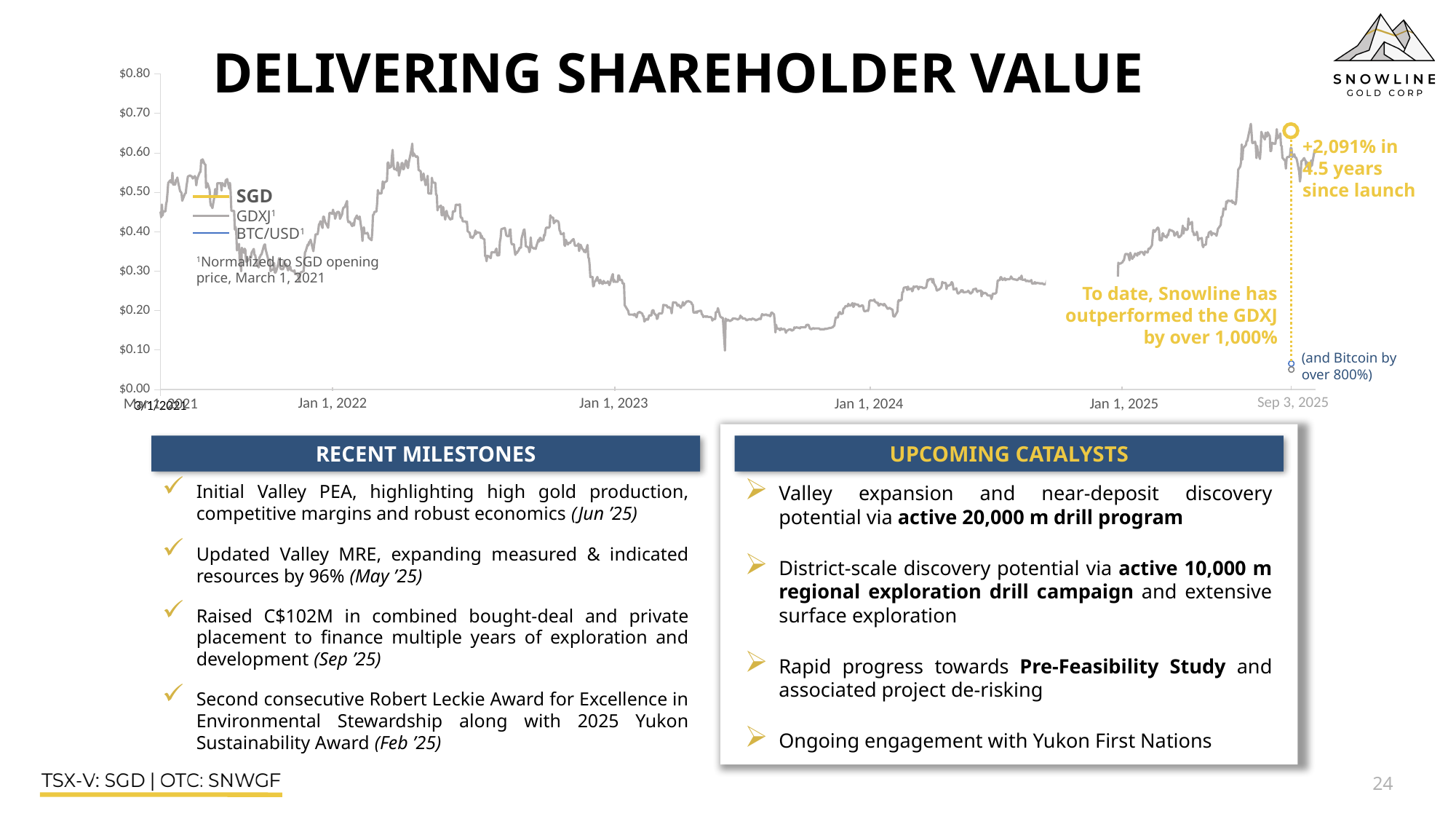
Is the value of the grey GDXJ line at Jan 1, 2024 greater or less than $0.30? less According to the chart annotation, by what percentage has SGD risen in 4.5 years since launch? +2,091% Which three series are listed in the chart legend? SGD, GDXJ, BTC/USD Is the value of the grey GDXJ line at Jan 1, 2022 greater or less than $0.30? greater What kind of chart is shown on the slide? line chart According to the chart annotation, by how much has Snowline outperformed the GDXJ to date? over 1,000% To what are the GDXJ and BTC/USD series normalized, according to the chart footnote? SGD opening price, March 1, 2021 Does the grey GDXJ line rise or fall between Jan 1, 2025 and Sep 3, 2025? rise How many series does the chart legend list? 3 What is the last date shown on the chart's x axis? Sep 3, 2025 What is the highest value shown on the chart's y axis? $0.80 According to the chart annotation, by how much has Snowline outperformed Bitcoin? over 800%